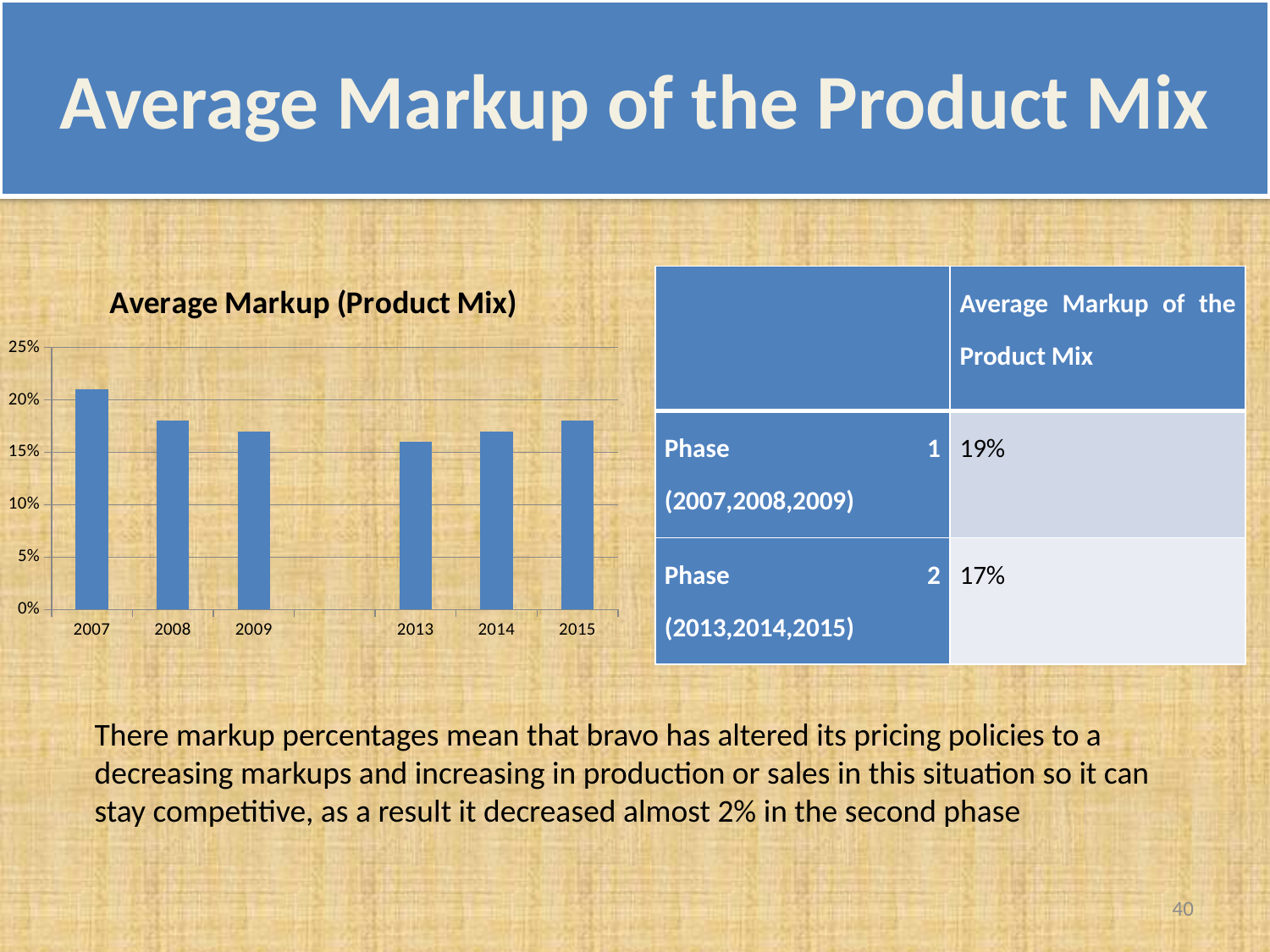
What is the title of the chart? Average Markup (Product Mix) Is the value for 2007 greater or less than 15%? greater Is the value for 2009 greater or less than 10%? greater How many years are shown on the x axis of the chart? 6 Is the value for 2013 greater or less than 20%? less Which is larger, the value for 2007 or the value for 2013? 2007 Do the values rise or fall from 2007 to 2009? fall Do the values rise or fall from 2013 to 2015? rise What kind of chart is shown on the slide? bar chart Which is larger, the value for 2008 or the value for 2013? 2008 Which year has the highest average markup in the chart? 2007